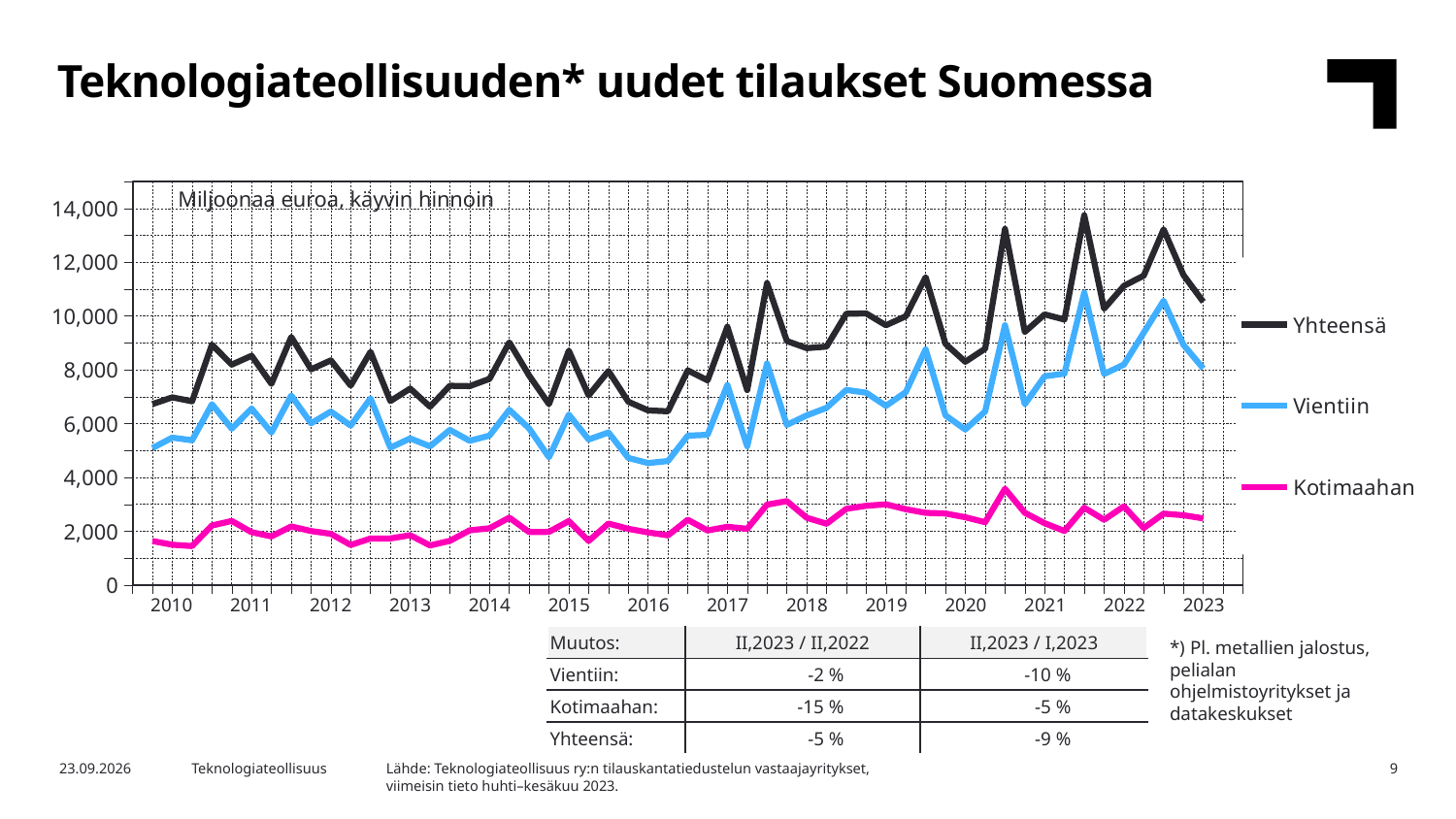
Which series has the lowest values throughout the chart? Kotimaahan Is the value of the Vientiin line in 2016 greater or less than 6,000? less How many series does the chart legend list? 3 Is the peak value of the Yhteensä line around 2021 greater or less than 12,000? greater What are the three series named in the chart legend? Yhteensä, Vientiin, Kotimaahan What kind of chart is shown on the slide? line chart Is the value of the Kotimaahan line at the start of 2010 greater or less than 4,000? less What unit is stated in the label inside the chart area? Miljoonaa euroa, käyvin hinnoin Which is larger in 2023, the Vientiin line or the Kotimaahan line? Vientiin Which series has the highest values throughout the chart? Yhteensä How many years are labelled on the x axis? 14